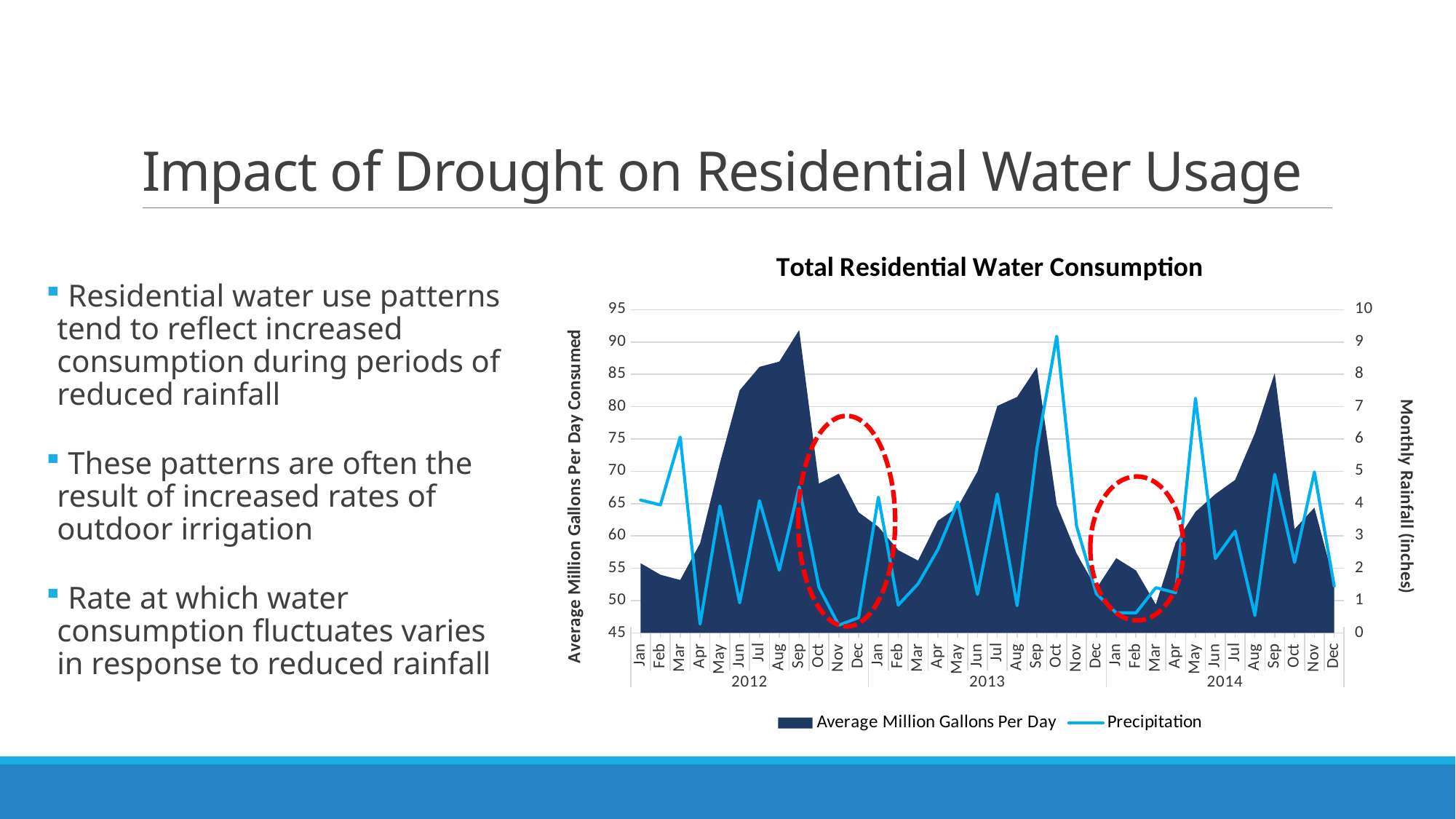
How many monthly data points are plotted along the x axis? 36 Is the Average Million Gallons Per Day value for Nov 2012 greater or less than 50? greater Is the Average Million Gallons Per Day value for Sep 2012 greater or less than 85? greater Which is larger, the Average Million Gallons Per Day value for Sep 2012 or for Sep 2013? Sep 2012 In which month and year does Precipitation reach its highest value? Oct 2013 Is the Precipitation value for Apr 2012 greater or less than 1? less How many years are shown along the x axis of the chart? 3 What kind of chart is shown on the slide? A combination area and line chart What is the title of the chart? Total Residential Water Consumption What is the label of the right-hand vertical axis? Monthly Rainfall (inches) How many series does the chart legend list? 2